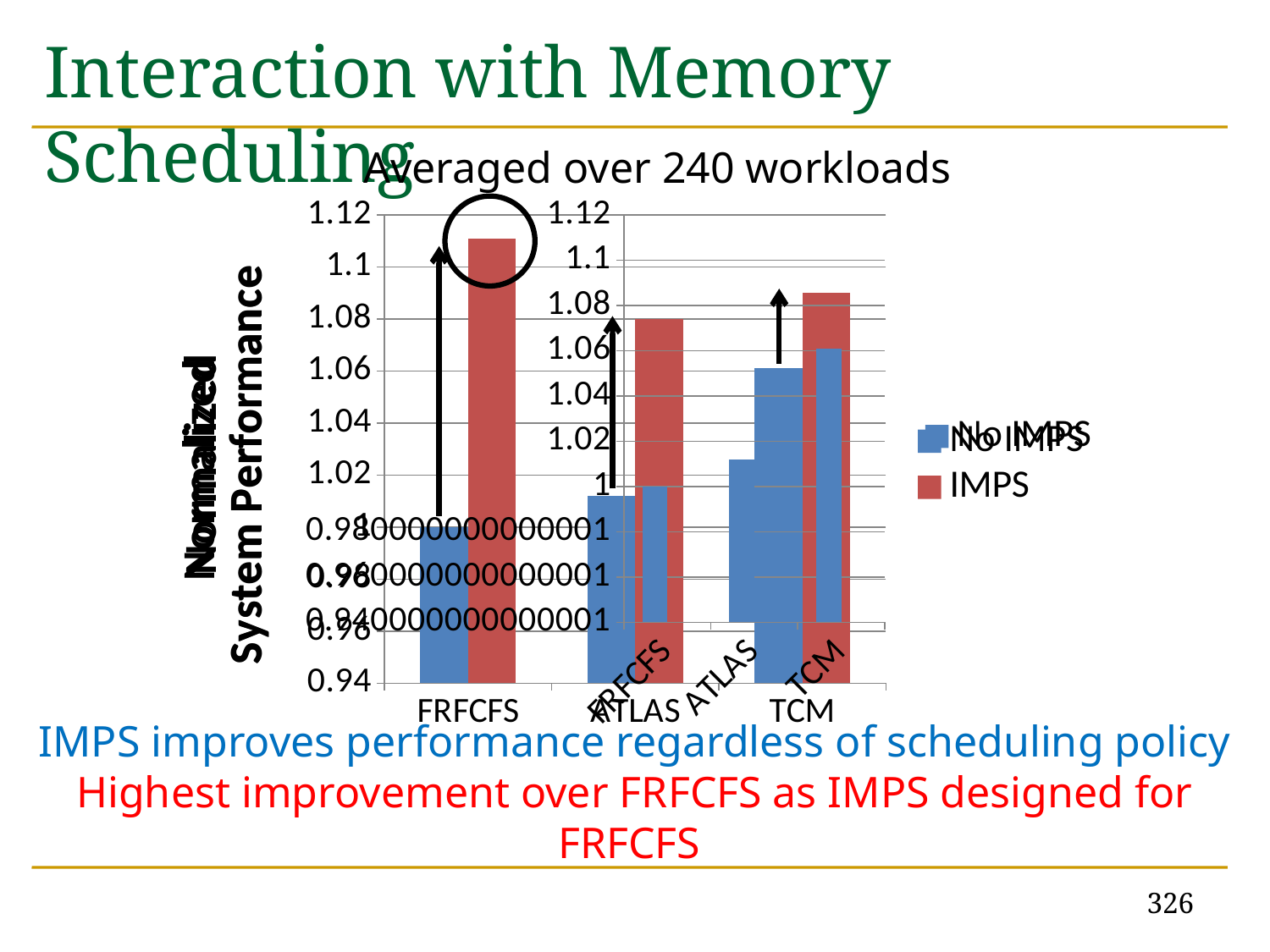
Which category has the highest IMPS bar? FRFCFS What kind of chart is shown on the slide? bar chart Which category has the lowest No IMPS bar? FRFCFS For ATLAS, which is larger: the No IMPS bar or the IMPS bar? IMPS For TCM, which is larger: the No IMPS bar or the IMPS bar? IMPS What is the title of the chart? Averaged over 240 workloads Is the IMPS value for FRFCFS greater or less than 1.1? greater How many scheduling policy categories are shown on the x axis? 3 What are the two series named in the legend? No IMPS and IMPS For FRFCFS, which is larger: the No IMPS bar or the IMPS bar? IMPS How many series does the chart legend list? 2